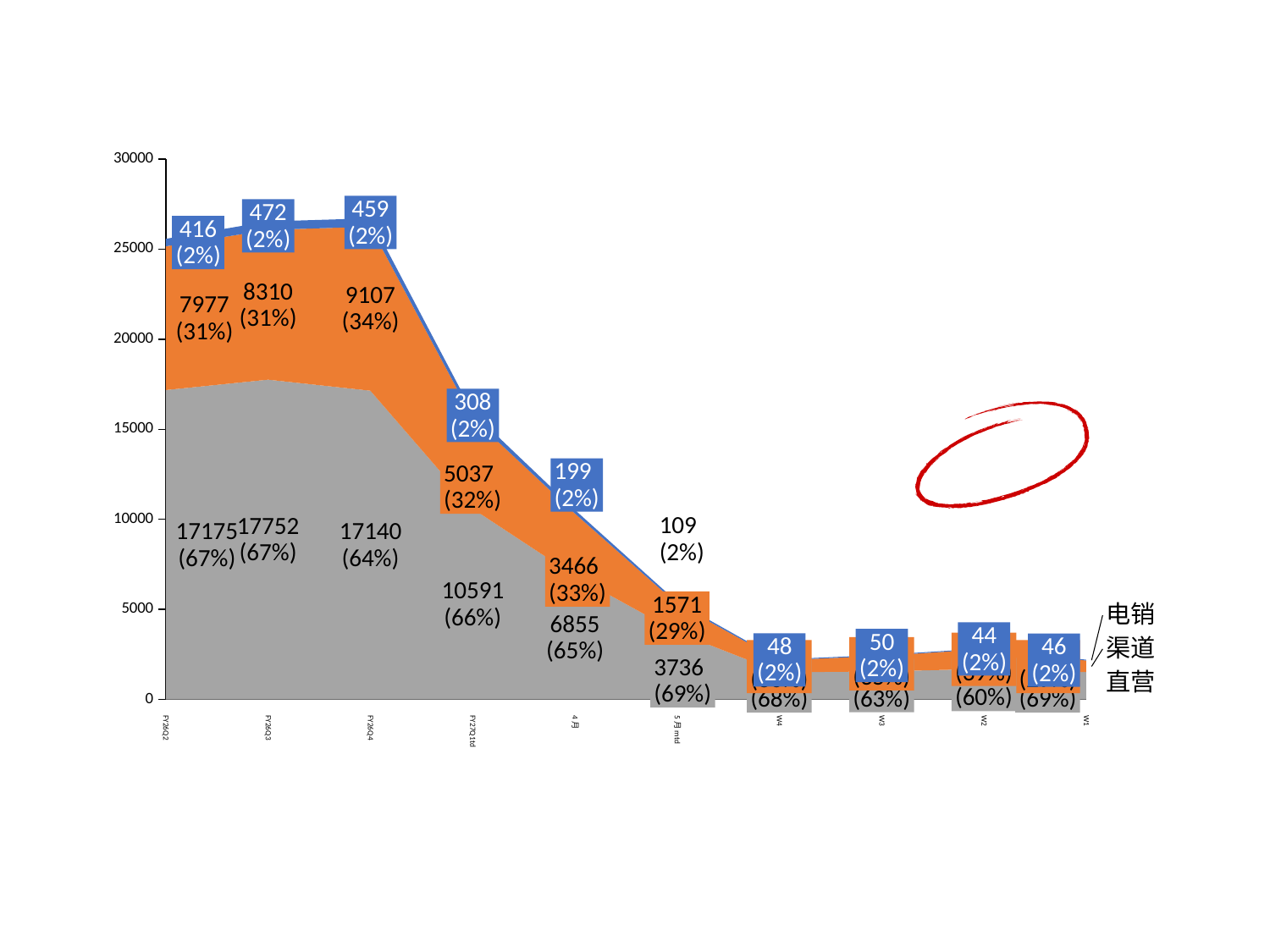
How many categories are on the x axis of the chart? 10 What kind of chart is shown on the slide? area chart How many series does the chart show (as labelled at the right)? 3 What is the value of 电销 for 4月? 199 (2%) What is the difference between the 渠道 values for FY26Q4 and FY27Q1td? 4070 In which category is the 电销 value highest? FY26Q3 Which is larger, the 直营 value for FY26Q2 or for FY26Q4? FY26Q2 What is the total of the stacked values for FY26Q2? 25568 What is the value of 直营 for FY26Q3? 17752 (67%) Do the 直营 values rise or fall from FY26Q3 to 5月mtd? fall What is the value of 渠道 for FY26Q4? 9107 (34%) In which category is the 直营 value lowest among those with a printed value? 5月mtd